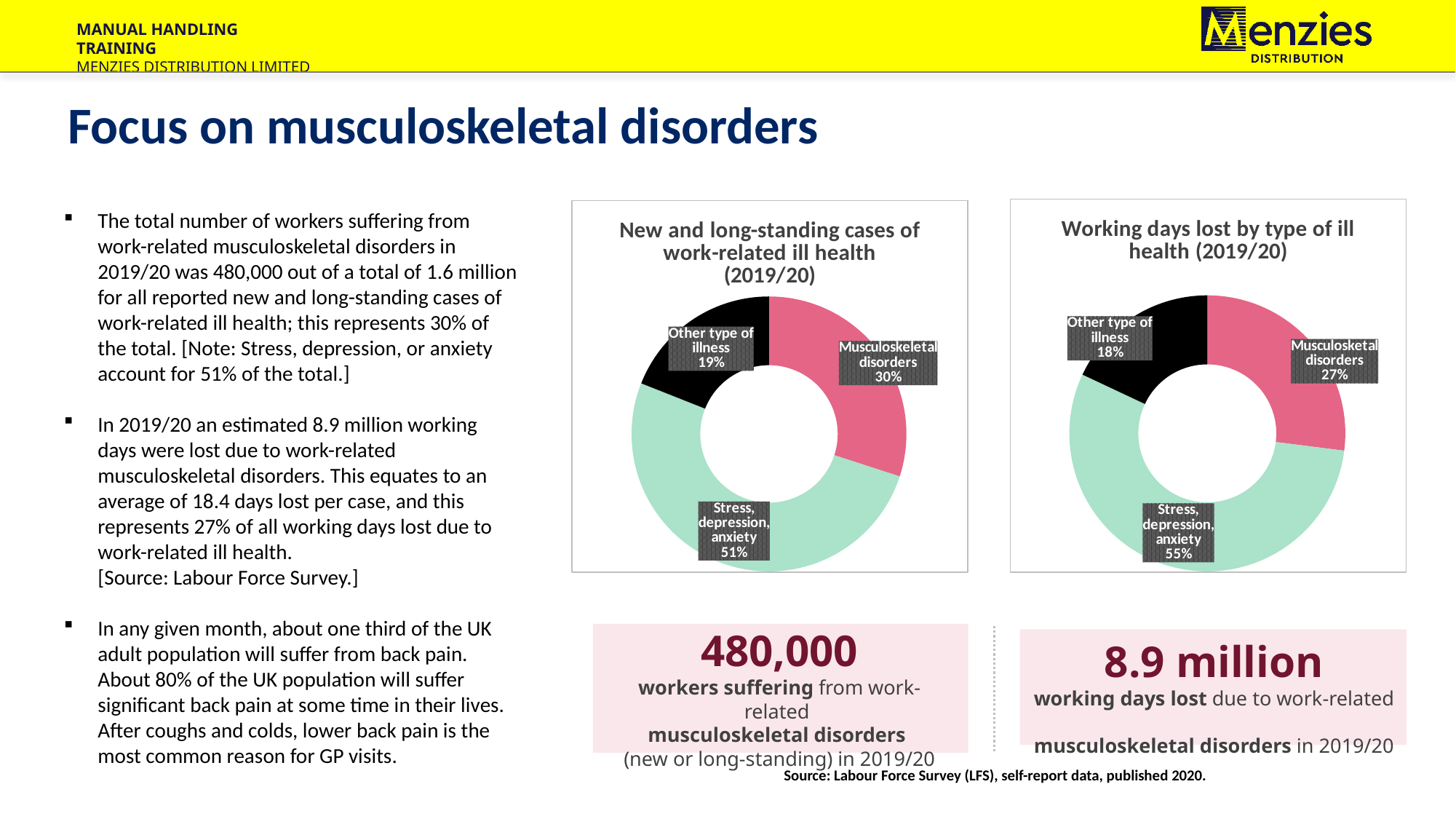
In the 'New and long-standing cases of work-related ill health (2019/20)' chart, what share is shown for Other type of illness? 19% In the 'Working days lost by type of ill health (2019/20)' chart, what share is shown for Other type of illness? 18% In the 'Working days lost by type of ill health (2019/20)' chart, what is the difference in percentage points between Stress, depression, anxiety and Musculoskeletal disorders? 28 In the 'New and long-standing cases of work-related ill health (2019/20)' chart, which category has the largest share? Stress, depression, anxiety In the 'New and long-standing cases of work-related ill health (2019/20)' chart, which is larger: Musculoskeletal disorders or Other type of illness? Musculoskeletal disorders In the 'New and long-standing cases of work-related ill health (2019/20)' chart, what share is shown for Musculoskeletal disorders? 30% In the 'New and long-standing cases of work-related ill health (2019/20)' chart, what share is shown for Stress, depression, anxiety? 51% How many categories are shown in the 'Working days lost by type of ill health (2019/20)' chart? 3 In the 'Working days lost by type of ill health (2019/20)' chart, what share is shown for Musculoskeletal disorders? 27% In the 'Working days lost by type of ill health (2019/20)' chart, which category has the smallest share? Other type of illness What type of chart is the 'New and long-standing cases of work-related ill health (2019/20)' chart? Doughnut chart In the 'Working days lost by type of ill health (2019/20)' chart, what share is shown for Stress, depression, anxiety? 55%